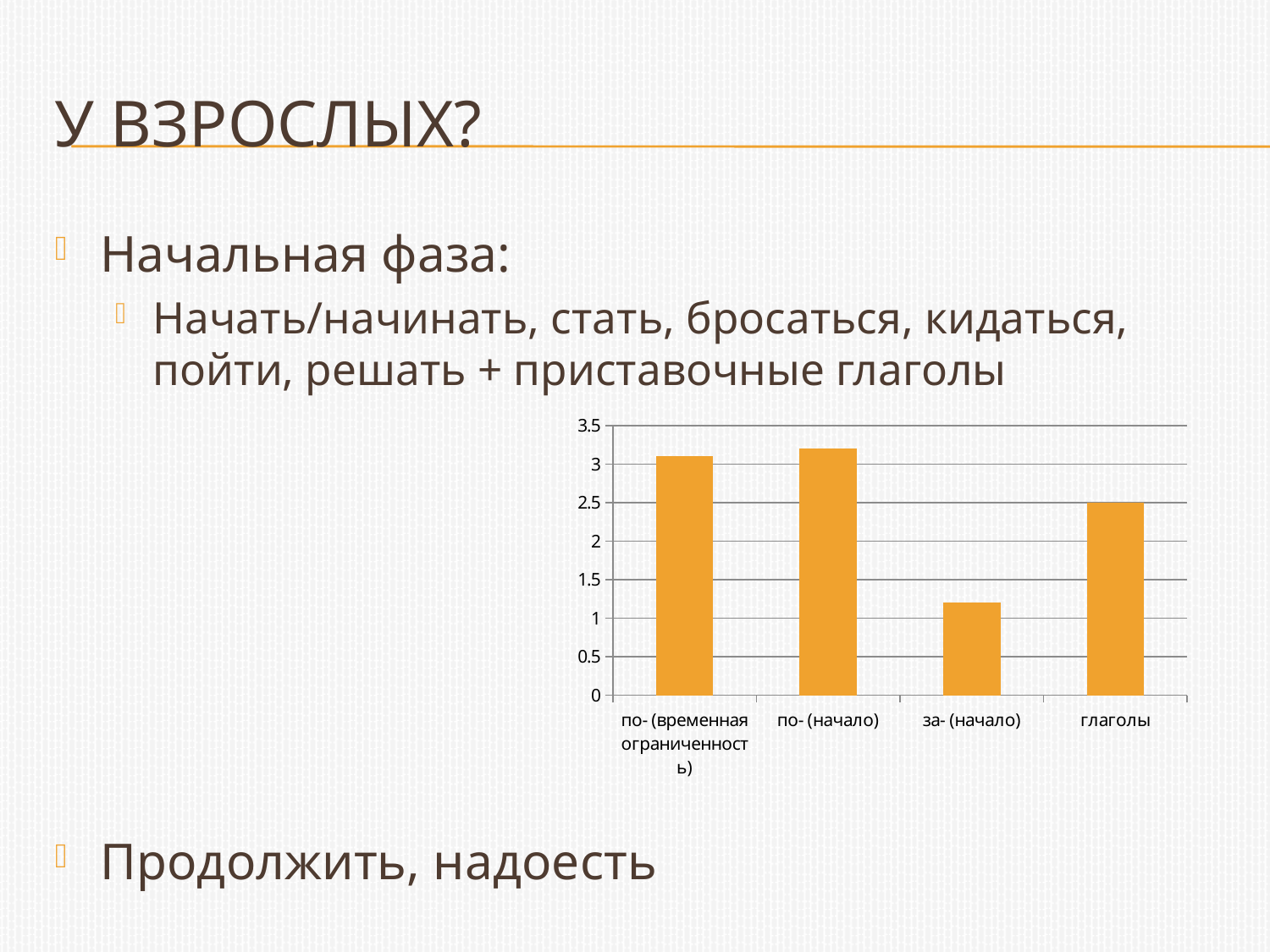
Which is larger in the chart: the value for за- (начало) or the value for глаголы? глаголы Which is larger in the chart: the value for по- (начало) or the value for глаголы? по- (начало) Is the value for по- (временная ограниченность) greater or less than 3.5? less Is the value for за- (начало) greater or less than 1.5? less Is the value for глаголы greater or less than 2? greater What is the highest value shown on the y axis of the chart? 3.5 Which category has the lowest bar in the chart? за- (начало) What kind of chart is shown on the slide? bar chart What colour are the bars in the chart? orange How many categories are shown on the x axis of the chart? 4